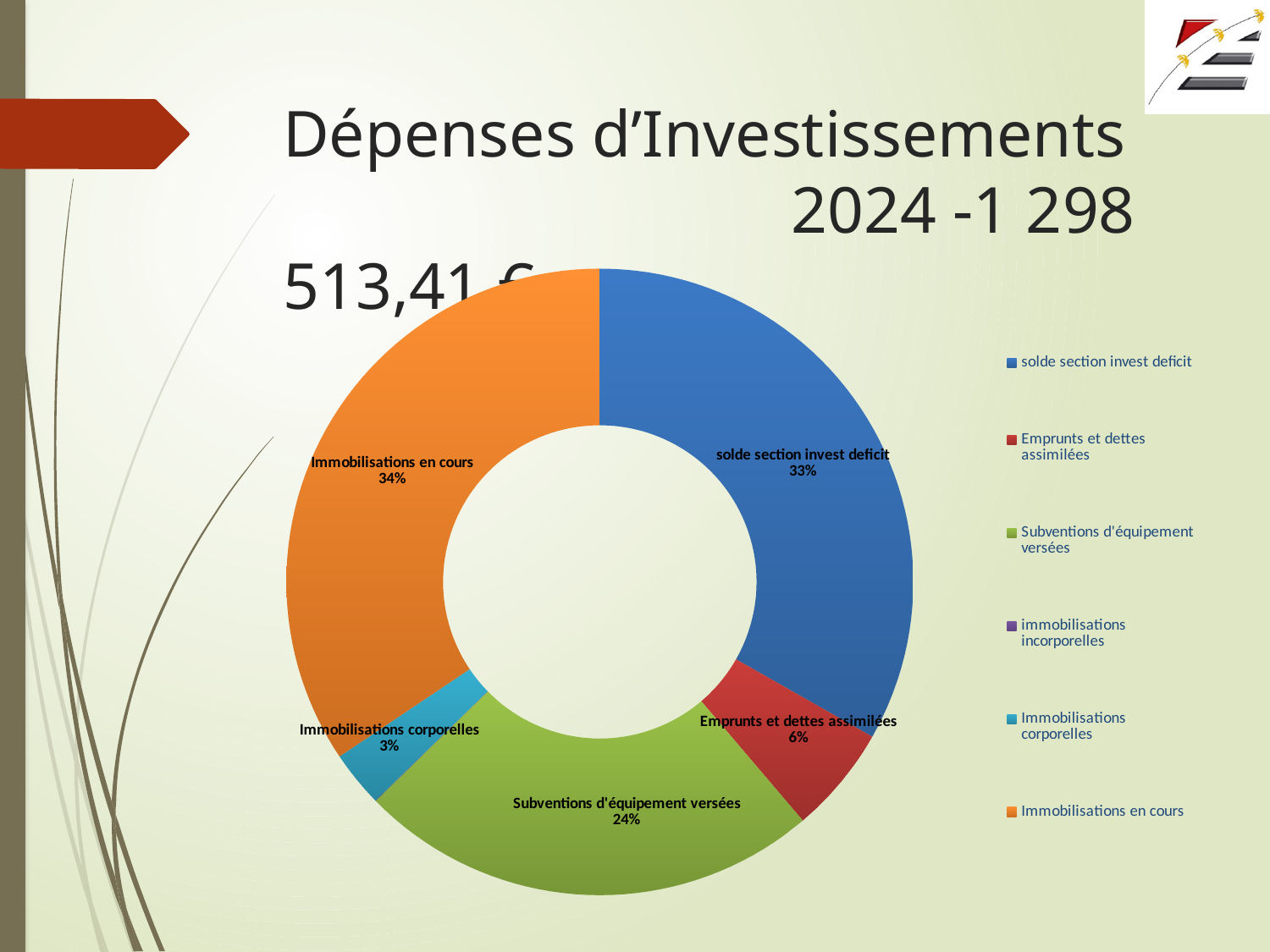
What kind of chart is shown on the slide? doughnut chart What percentage is shown for 'Immobilisations corporelles'? 3% Which is larger: the share for 'Subventions d'équipement versées' or for 'Emprunts et dettes assimilées'? Subventions d'équipement versées Which labelled slice has the smallest share of the chart? Immobilisations corporelles What percentage is shown for 'Emprunts et dettes assimilées'? 6% What colour is the 'Immobilisations en cours' slice? orange Which labelled slice has the largest share of the chart? Immobilisations en cours What is the difference in percentage points between 'Immobilisations en cours' and 'Subventions d'équipement versées'? 10 percentage points How many entries does the chart legend list? 6 What percentage is shown for 'Subventions d'équipement versées'? 24% What percentage share does the slice 'solde section invest deficit' have? 33% What percentage is shown for 'Immobilisations en cours'? 34%